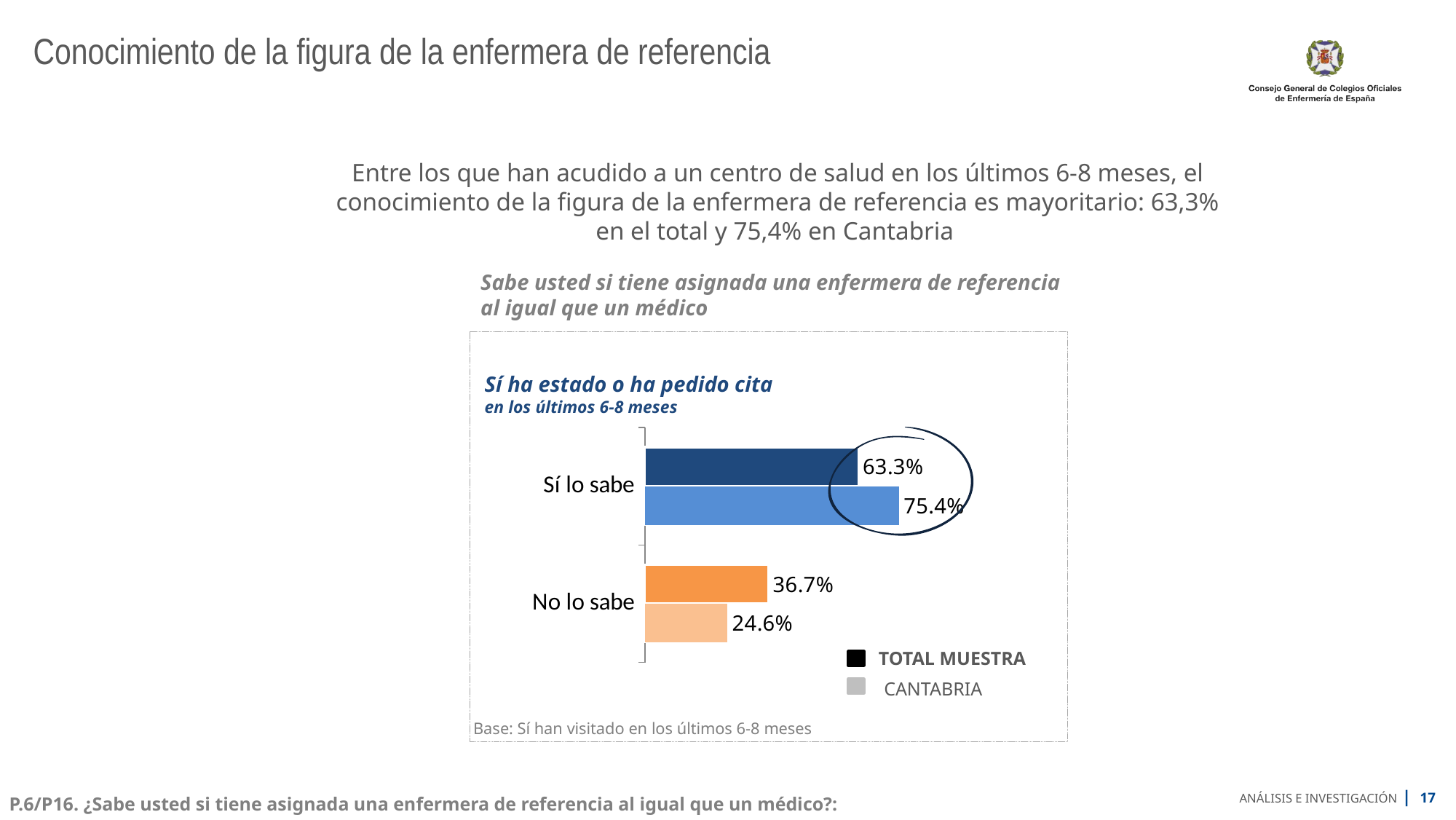
What is the value for 'No lo sabe' in the CANTABRIA series? 24.6% Which is larger for 'No lo sabe': TOTAL MUESTRA or CANTABRIA? TOTAL MUESTRA Which category has the lowest value in the TOTAL MUESTRA series? No lo sabe How many categories are shown in the chart? 2 How many series does the legend list? 2 What is the value for 'No lo sabe' in the TOTAL MUESTRA series? 36.7% What is the difference between the TOTAL MUESTRA and CANTABRIA values for 'No lo sabe'? 12.1% What is the value for 'Sí lo sabe' in the TOTAL MUESTRA series? 63.3% Which category has the highest value in the CANTABRIA series? Sí lo sabe What is the value for 'Sí lo sabe' in the CANTABRIA series? 75.4% What is the difference between the CANTABRIA and TOTAL MUESTRA values for 'Sí lo sabe'? 12.1% What kind of chart is shown on the slide? Bar chart